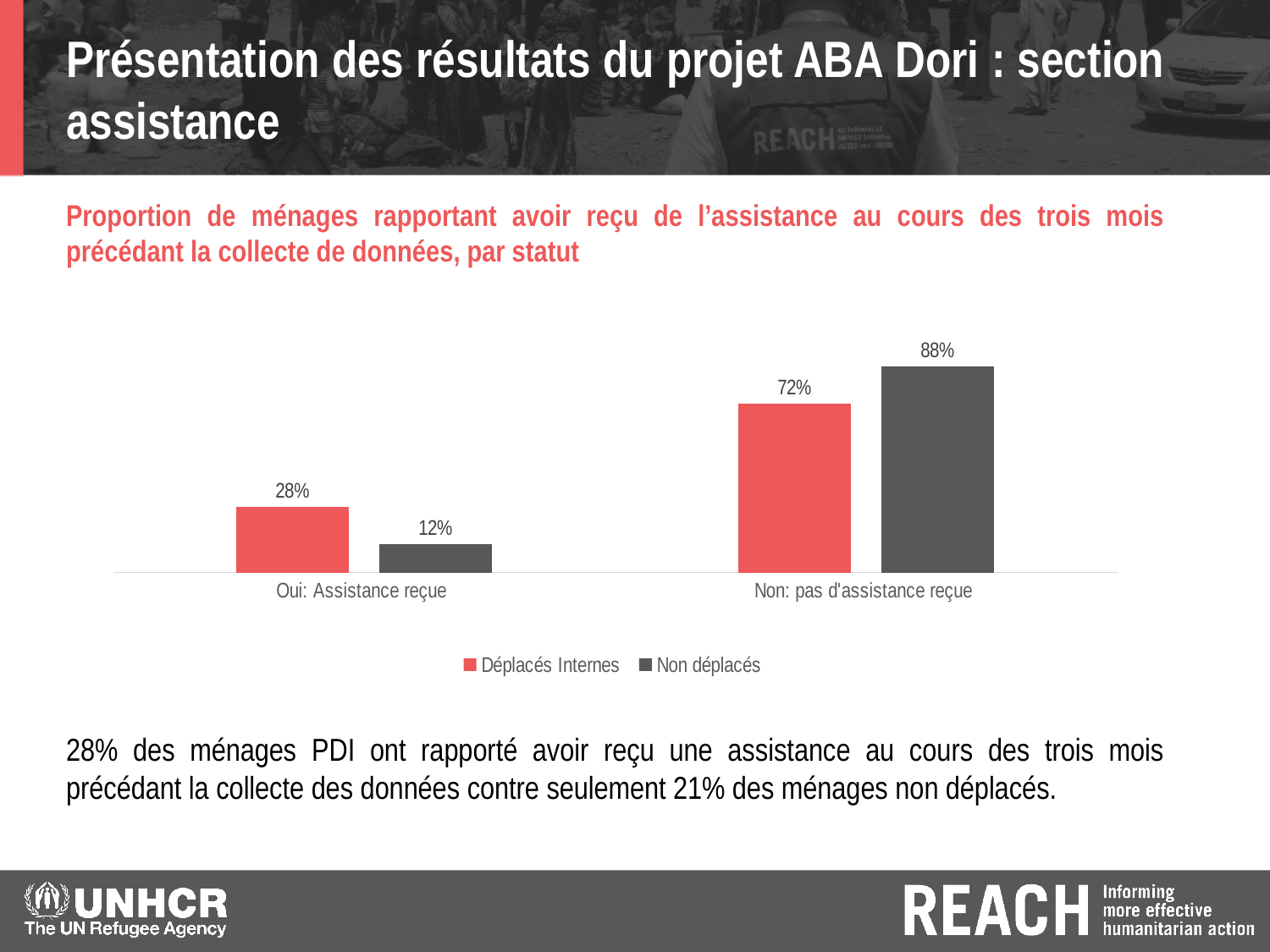
What is the value for Déplacés Internes in the 'Non: pas d'assistance reçue' category? 72% In the 'Oui: Assistance reçue' category, which series has the larger value, Déplacés Internes or Non déplacés? Déplacés Internes What type of chart is shown on the slide? Bar chart What is the difference between the Non déplacés and Déplacés Internes values in the 'Non: pas d'assistance reçue' category? 16 percentage points What percentage of Non déplacés households reported receiving assistance (Oui: Assistance reçue)? 12% What is the difference between the Déplacés Internes and Non déplacés values in the 'Oui: Assistance reçue' category? 16 percentage points Which bar has the highest value on the chart? Non déplacés, Non: pas d'assistance reçue (88%) What percentage of Déplacés Internes households reported receiving assistance (Oui: Assistance reçue)? 28% How many categories are shown on the x axis of the chart? 2 What is the value for Non déplacés in the 'Non: pas d'assistance reçue' category? 88% How many series does the legend list? 2 Which bar has the lowest value on the chart? Non déplacés, Oui: Assistance reçue (12%)